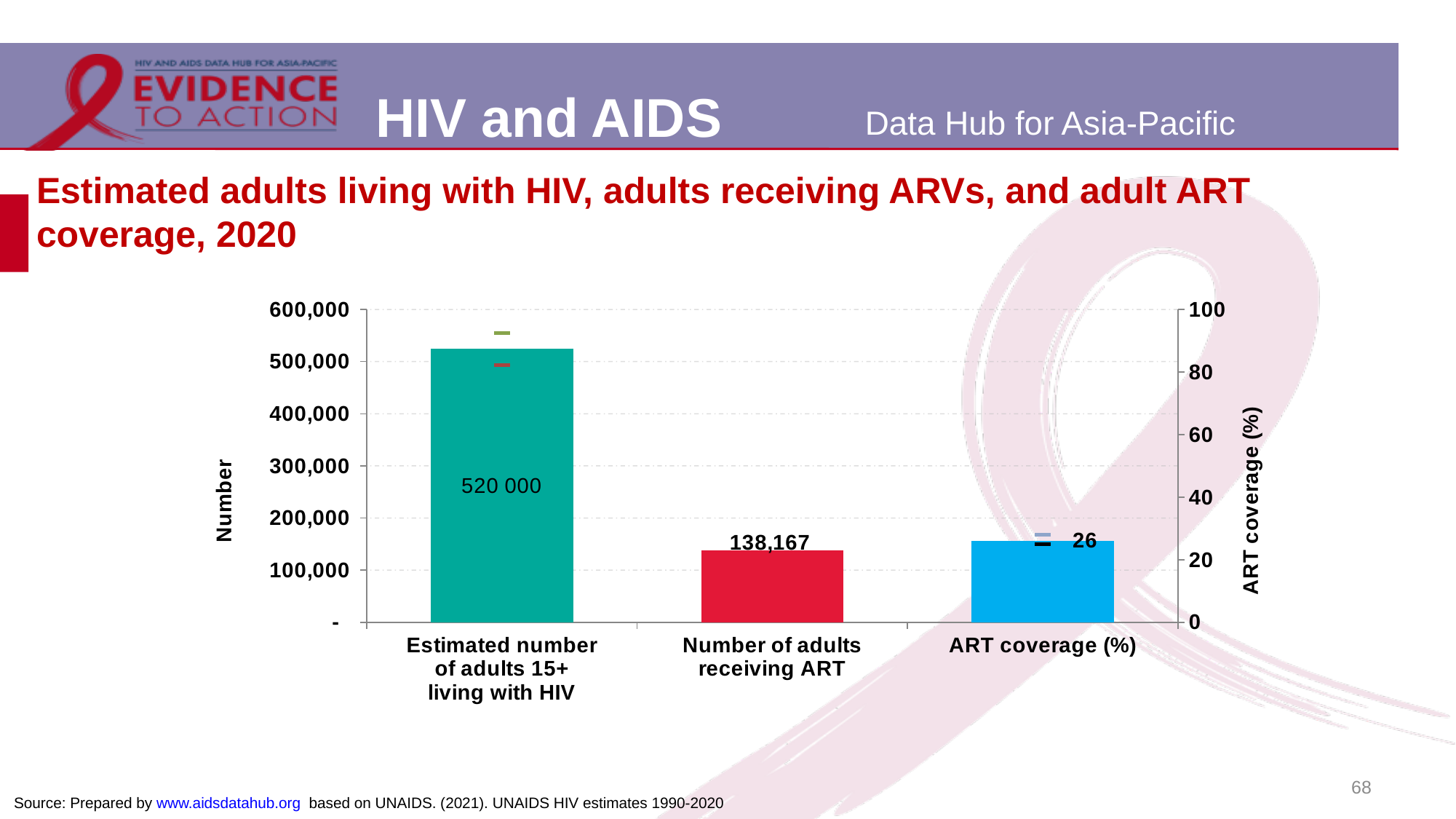
What is the difference between the estimated number of adults 15+ living with HIV and the number of adults receiving ART? 381,833 What is the estimated number of adults 15+ living with HIV shown on the chart? 520 000 What kind of chart is shown on the slide? Bar chart Is the ART coverage (%) value greater or less than 20 on the right-hand axis? greater Which category has the tallest bar on the chart? Estimated number of adults 15+ living with HIV What is the title of the right-hand vertical axis? ART coverage (%) How many categories are shown on the x axis of the chart? 3 What is the number of adults receiving ART shown on the chart? 138,167 What is the title of the left-hand vertical axis? Number What is the adult ART coverage (%) shown on the chart? 26 Which is larger: the estimated number of adults 15+ living with HIV or the number of adults receiving ART? Estimated number of adults 15+ living with HIV Is the value for the number of adults receiving ART greater or less than 200,000? less